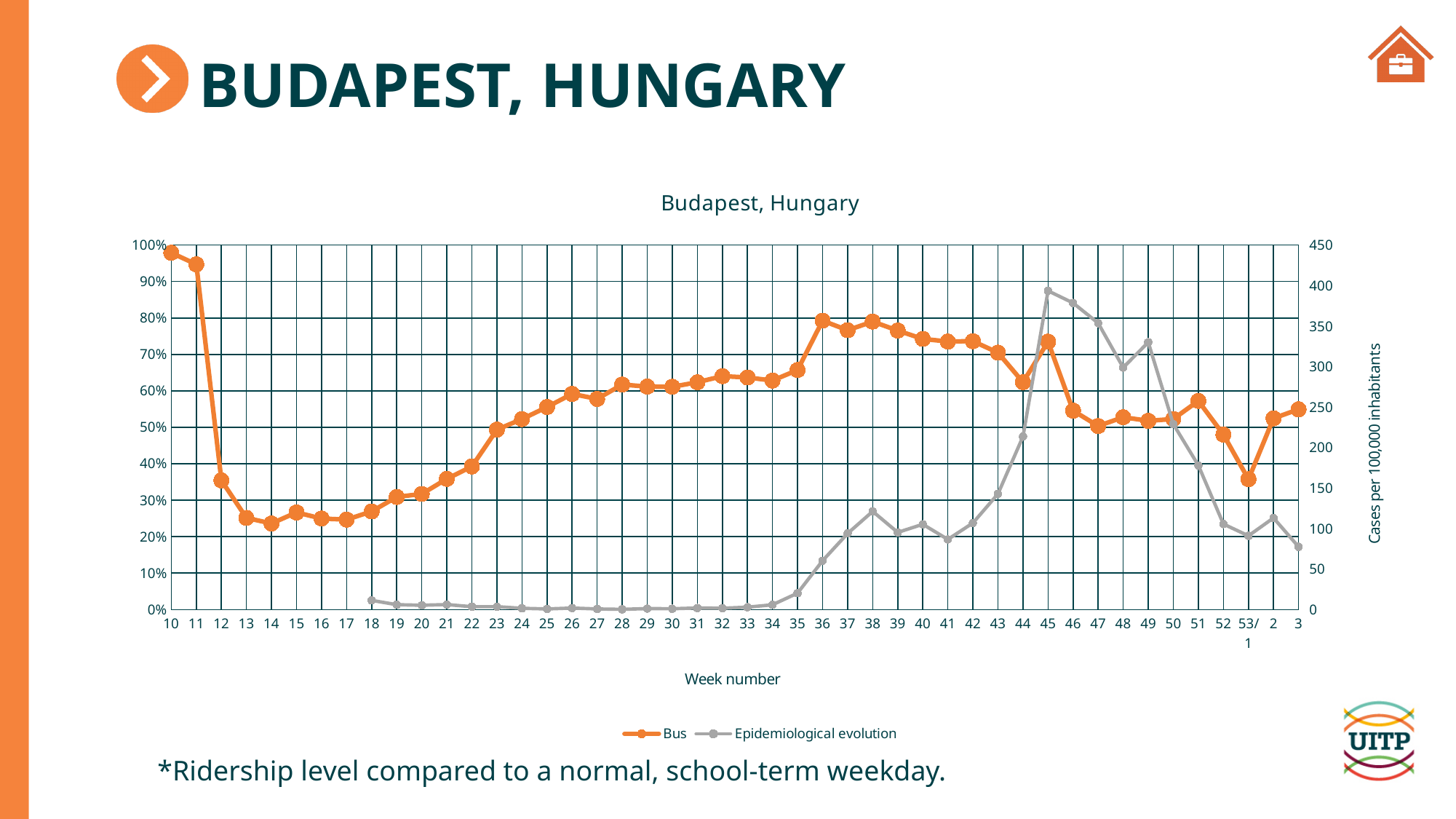
Is the Epidemiological evolution value for week 3 greater or less than 100? less What are the two series named in the legend? Bus and Epidemiological evolution Is the Bus value for week 53/1 greater or less than 40%? less What kind of chart is shown on the slide? line chart How many series does the legend list? 2 Is the Bus value for week 12 greater or less than 30%? greater What is the label of the right-hand vertical axis? Cases per 100,000 inhabitants Does the Bus series rise or fall from week 17 to week 26? rise Which is larger, the Bus value for week 36 or the Bus value for week 13? week 36 At which week number does the Epidemiological evolution series reach its peak? 45 At which week number is the Bus series at its highest? 10